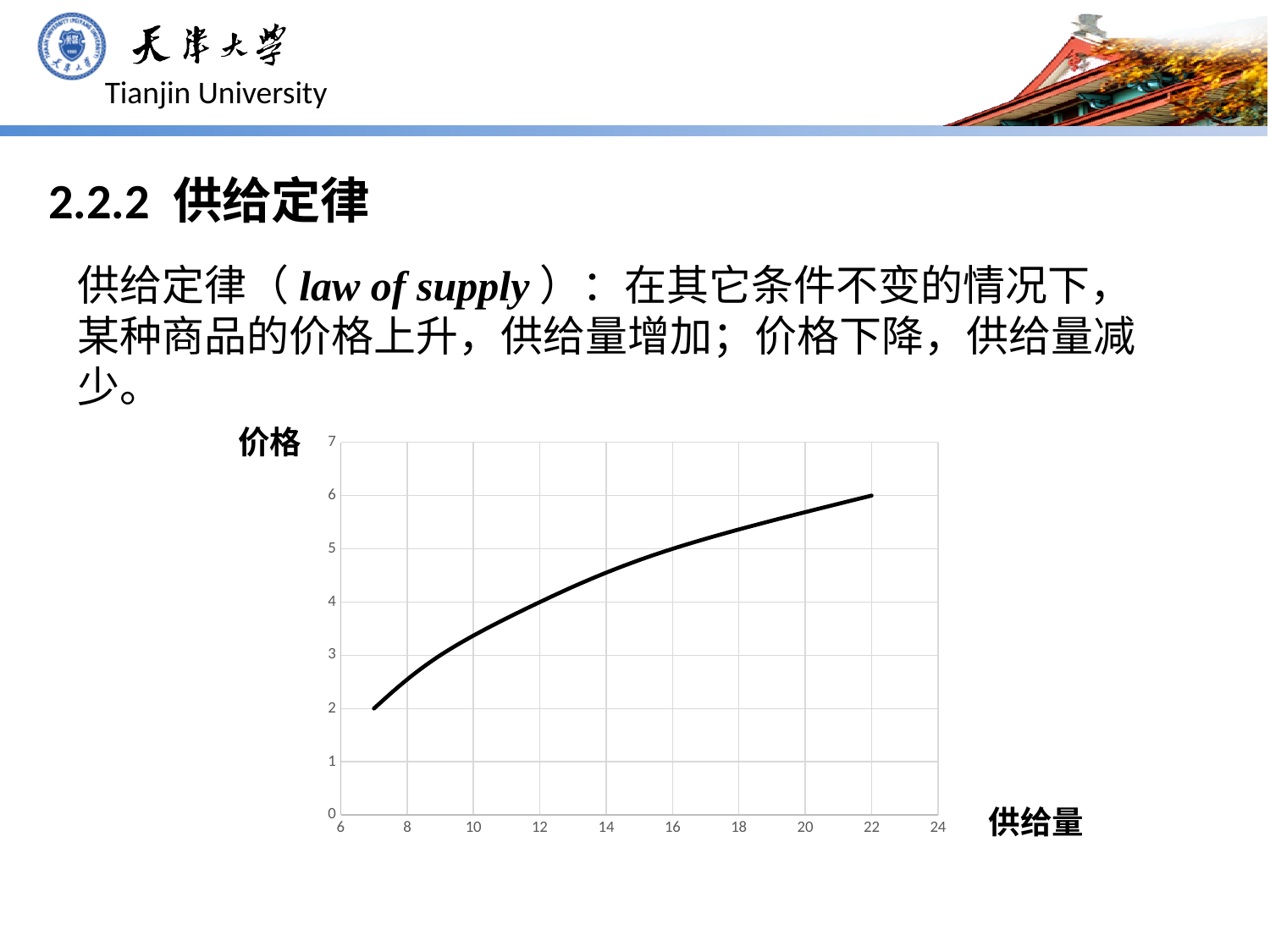
What is the highest 价格 value reached by the curve? 6 Is the 价格 value at 供给量 = 8 greater or less than 3? less Is the 价格 value at 供给量 = 18 greater or less than 5? greater What type of chart is shown on the slide? line chart What is the 价格 value at the left end of the curve? 2 What is the label of the vertical axis of the chart? 价格 Is the 价格 at 供给量 = 20 larger or smaller than the 价格 at 供给量 = 12? larger What is the 价格 value at the right end of the curve, where 供给量 is 22? 6 What is the lowest 价格 value on the curve? 2 Is the 价格 value at 供给量 = 10 greater or less than 3? greater What is the label of the horizontal axis of the chart? 供给量 As 供给量 increases along the x axis, does 价格 rise or fall? rise